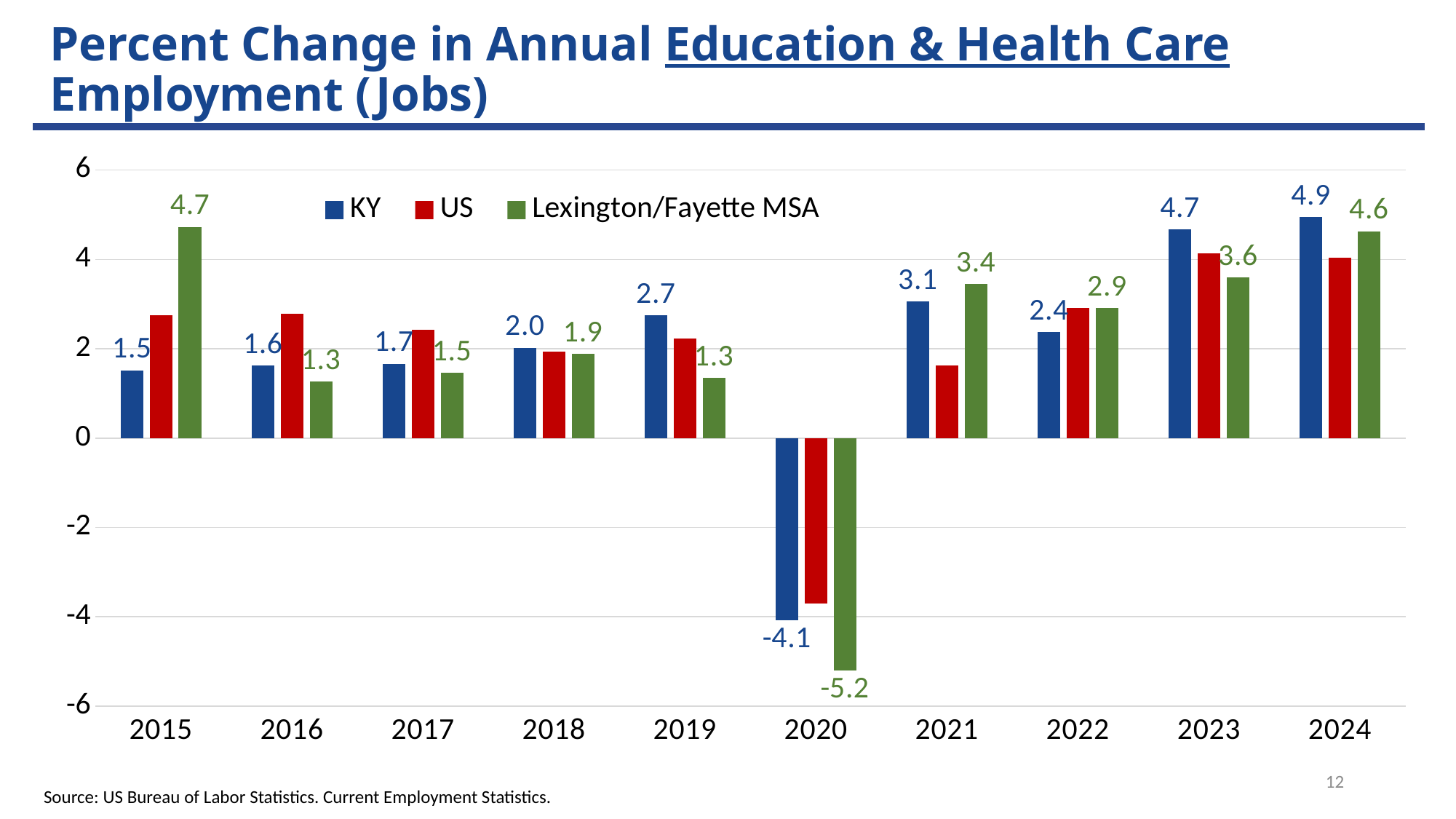
What is the value for Lexington/Fayette MSA in 2020? -5.2 What kind of chart is shown on the slide? bar chart In which year is the KY value highest? 2024 How many series does the legend list? 3 What is the value for Lexington/Fayette MSA in 2015? 4.7 In which year is the KY value lowest? 2020 Is the value for US in 2020 greater or less than -2? less What is the difference between the Lexington/Fayette MSA value and the KY value in 2015? 3.2 Which is larger in 2019, the KY value or the Lexington/Fayette MSA value? KY How many years are shown on the x axis? 10 Is the value for US in 2015 greater or less than 2? greater What is the value for KY in 2024? 4.9